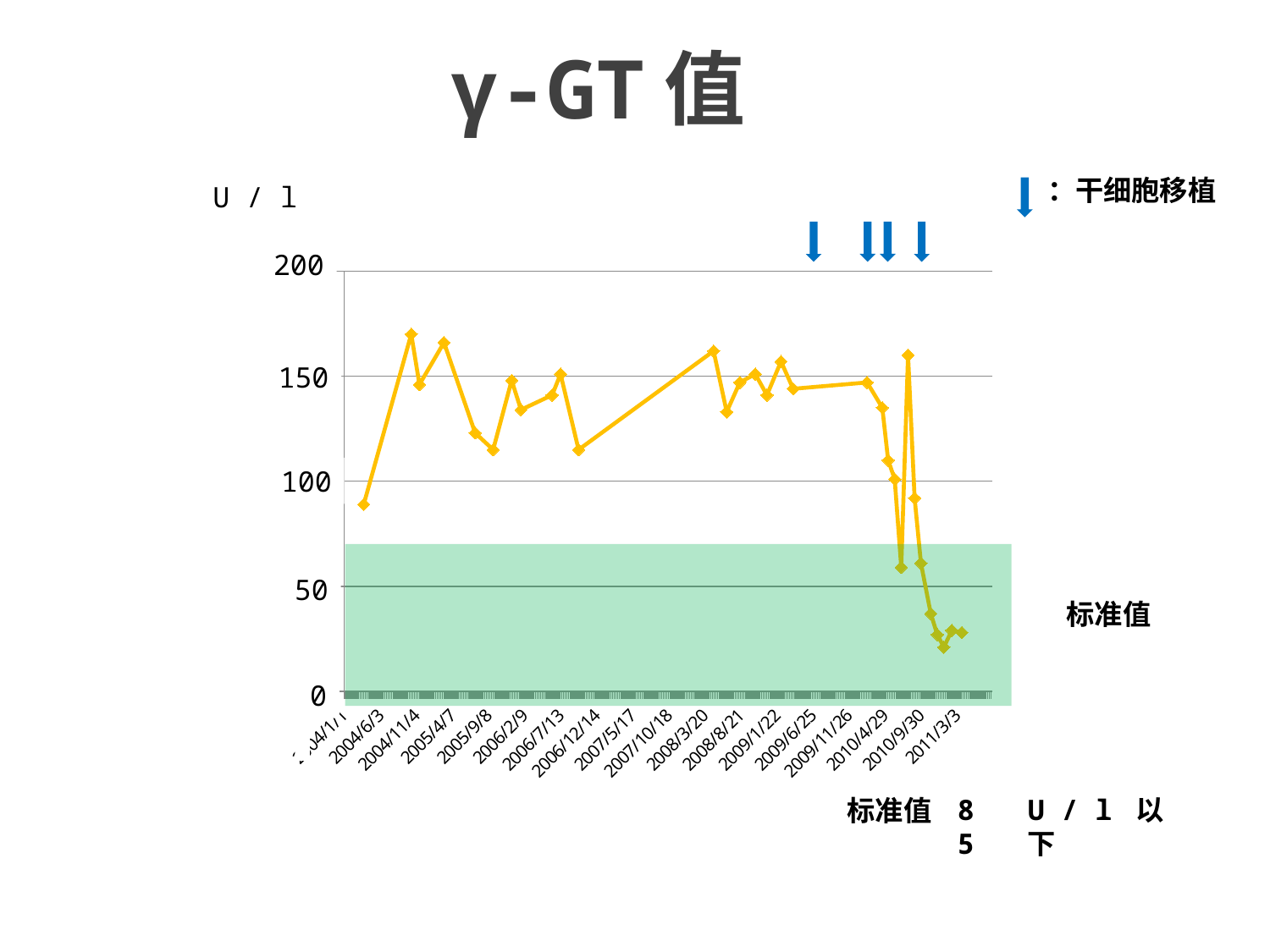
Is the value plotted at 2009/1/22 greater or less than 100? greater Is the value plotted at 2011/3/3 greater or less than 50? less Is the value plotted at 2006/12/14 greater or less than 100? greater What is the title of the chart? γ-GT 値 Is the value at the last plotted point higher or lower than the value at the first plotted point? lower Do the plotted values rise or fall from 2010/9/30 to the end of the series? fall What kind of chart is shown on the slide? line chart What unit is shown for the y axis of the chart? U / l